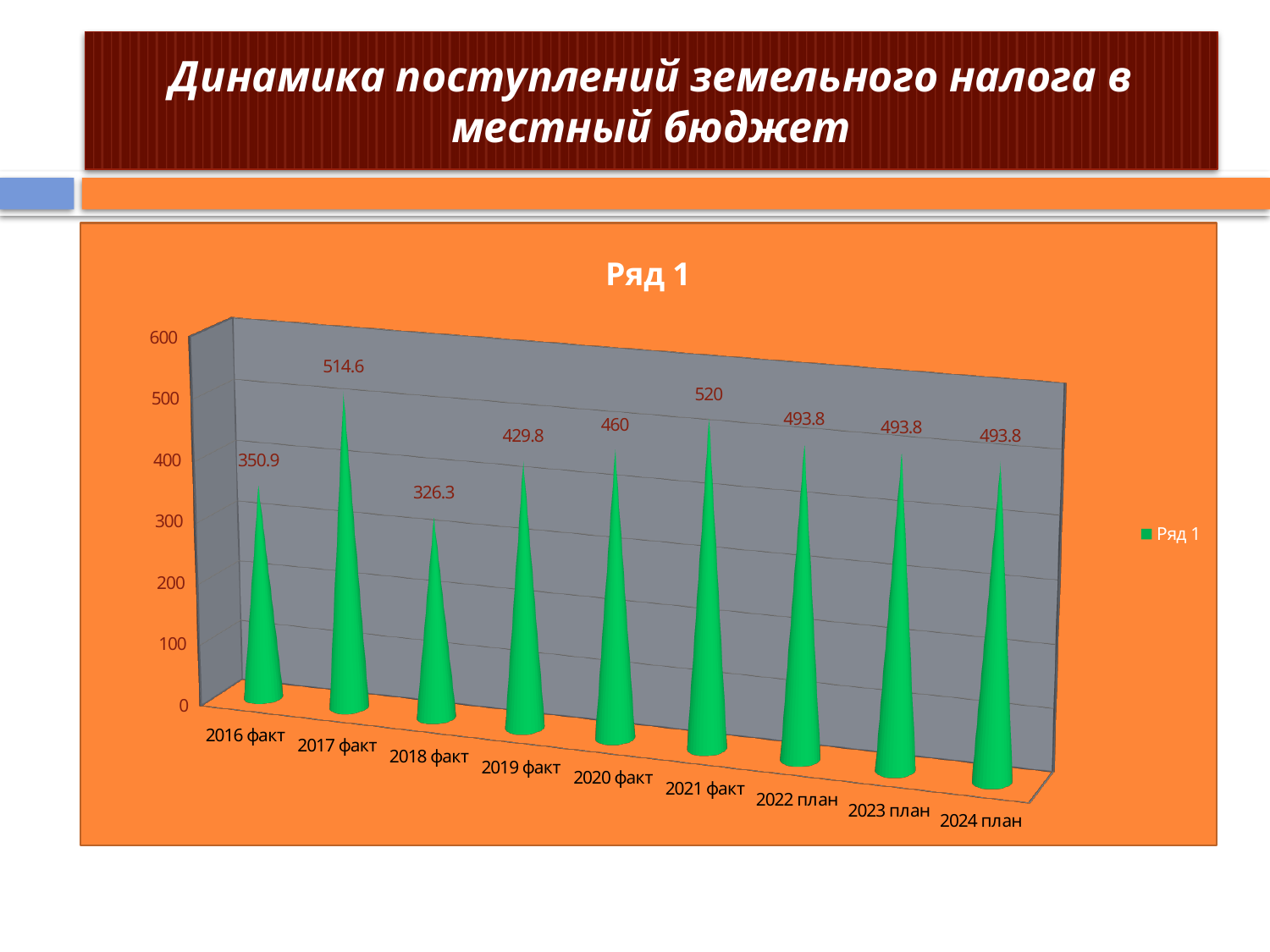
What is the value for 2022 план? 493.8 Which category has the lowest value? 2018 факт What is the difference between the values for 2021 факт and 2020 факт? 60 Which is larger, the value for 2019 факт or the value for 2020 факт? 2020 факт What is the title of the chart? Ряд 1 Which category has the highest value? 2021 факт What is the value for 2017 факт? 514.6 What is the value for 2016 факт? 350.9 What is the value for 2019 факт? 429.8 How many series does the legend list? 1 What is the difference between the values for 2017 факт and 2016 факт? 163.7 How many categories are shown on the x axis? 9